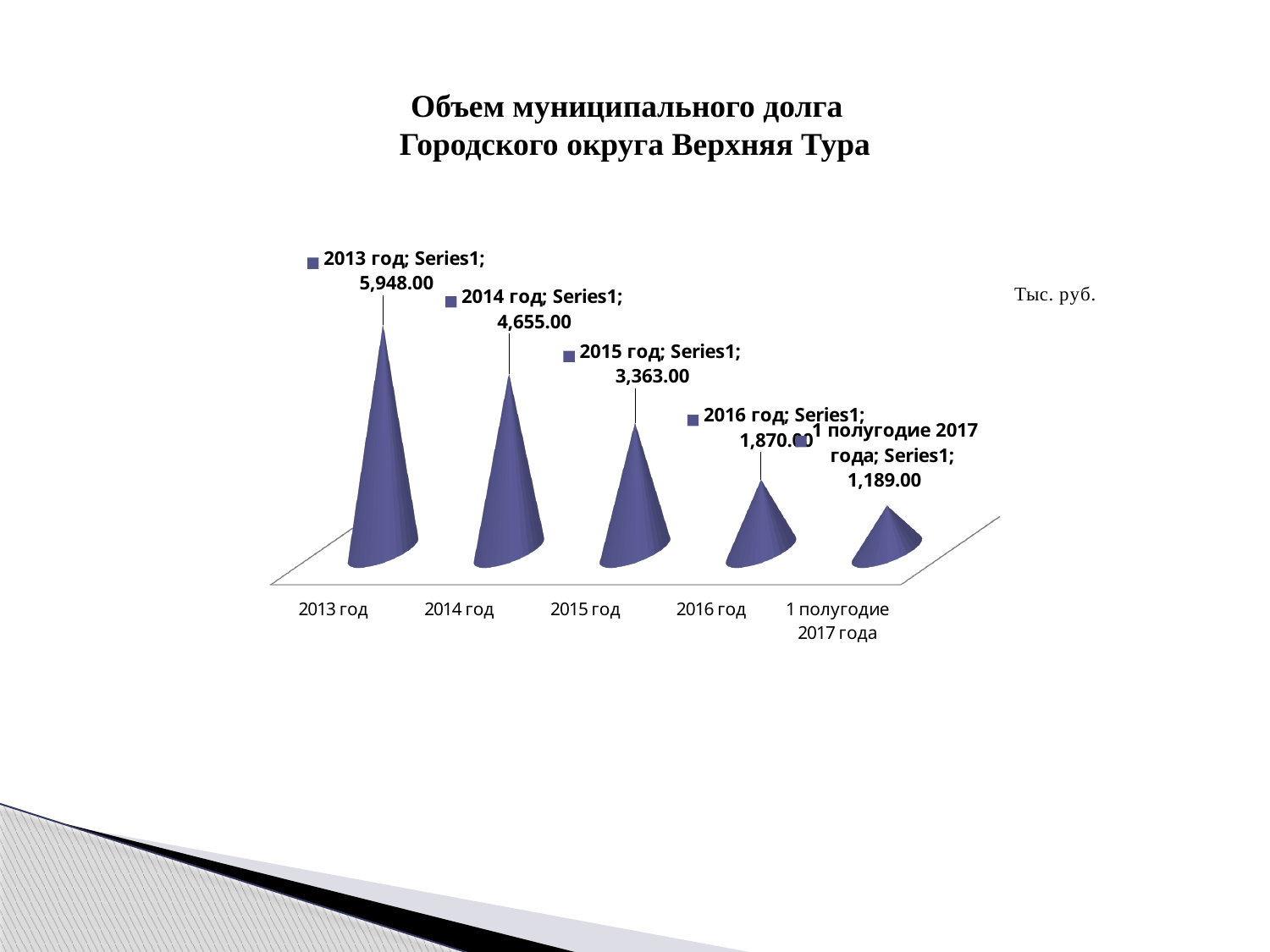
What is the value for 2014 год? 4,655.00 Which category has the highest value? 2013 год How many categories are shown on the x axis? 5 What is the difference between the values for 2013 год and 2014 год? 1,293.00 Which is larger, the value for 2014 год or the value for 2015 год? 2014 год Which category has the lowest value? 1 полугодие 2017 года What unit is indicated next to the chart? Тыс. руб. What is the value for 1 полугодие 2017 года? 1,189.00 What is the value for 2015 год? 3,363.00 What is the difference between the values for 2015 год and 1 полугодие 2017 года? 2,174.00 Do the values rise or fall from 2013 год to 1 полугодие 2017 года? fall What is the value for 2013 год? 5,948.00